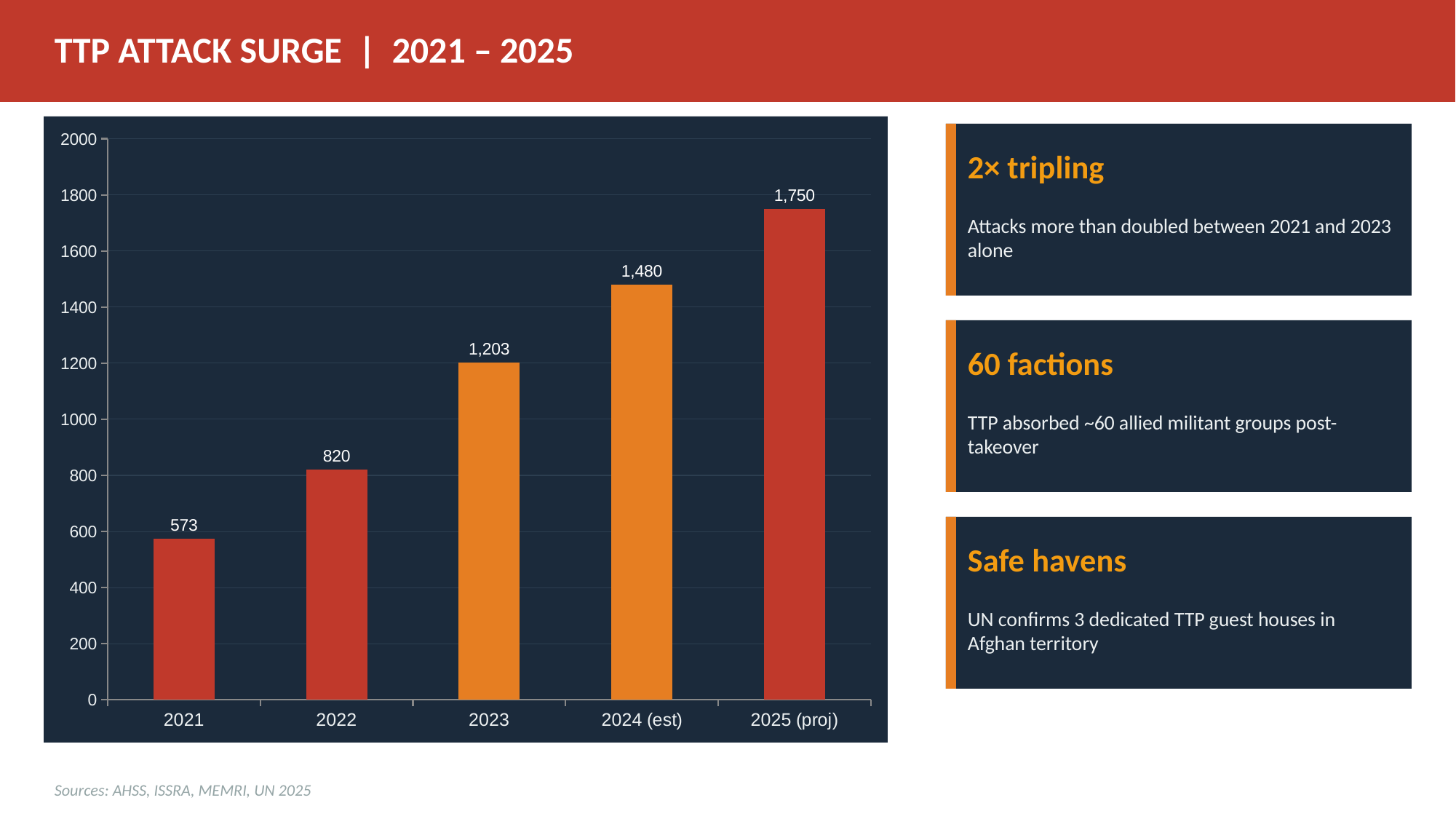
What is the difference between the values for 2022 and 2021? 247 Which category has the highest value? 2025 (proj) Which category has the lowest value? 2021 How many categories are shown on the x axis? 5 What is the difference between the values for 2025 (proj) and 2024 (est)? 270 Is the value for 2024 (est) greater or less than 1400? greater What kind of chart is shown? bar chart What is the value for 2023? 1,203 Which is larger, the value for 2023 or the value for 2022? 2023 What is the value for 2025 (proj)? 1,750 What is the value for 2021? 573 What is the value for 2024 (est)? 1,480